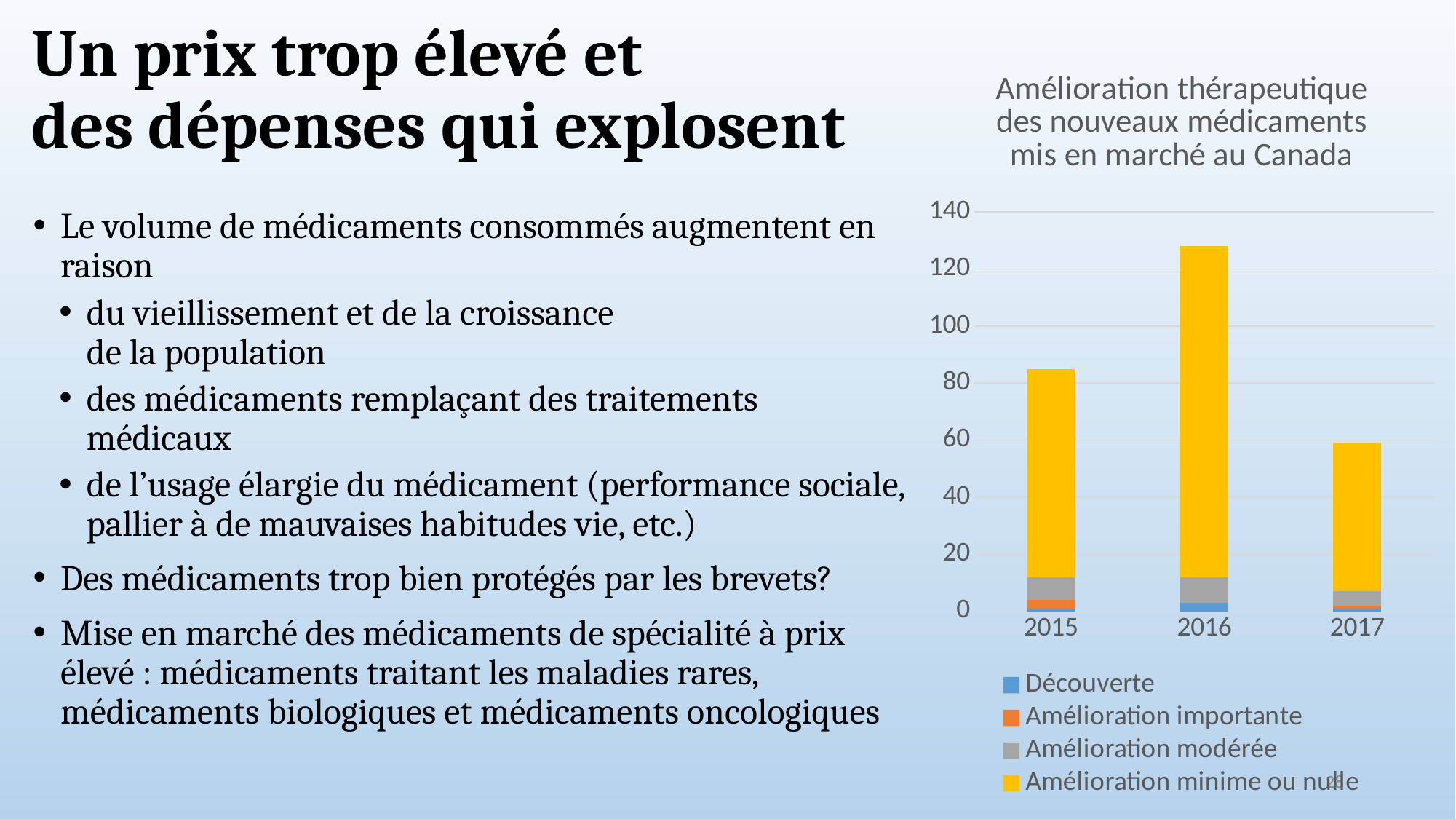
Is the total bar height for 2015 greater or less than 80? greater Which year has the tallest stacked bar? 2016 How many years are shown on the x axis of the chart? 3 What is the title of the chart? Amélioration thérapeutique des nouveaux médicaments mis en marché au Canada Does the total bar height rise or fall from 2016 to 2017? fall Which is larger, the total bar for 2015 or the total bar for 2017? 2015 How many series does the chart legend list? 4 Is the total bar height for 2016 greater or less than 120? greater Which series makes up the largest part of each bar? Amélioration minime ou nulle What kind of chart is shown on the slide? stacked bar chart Which year has the shortest stacked bar? 2017